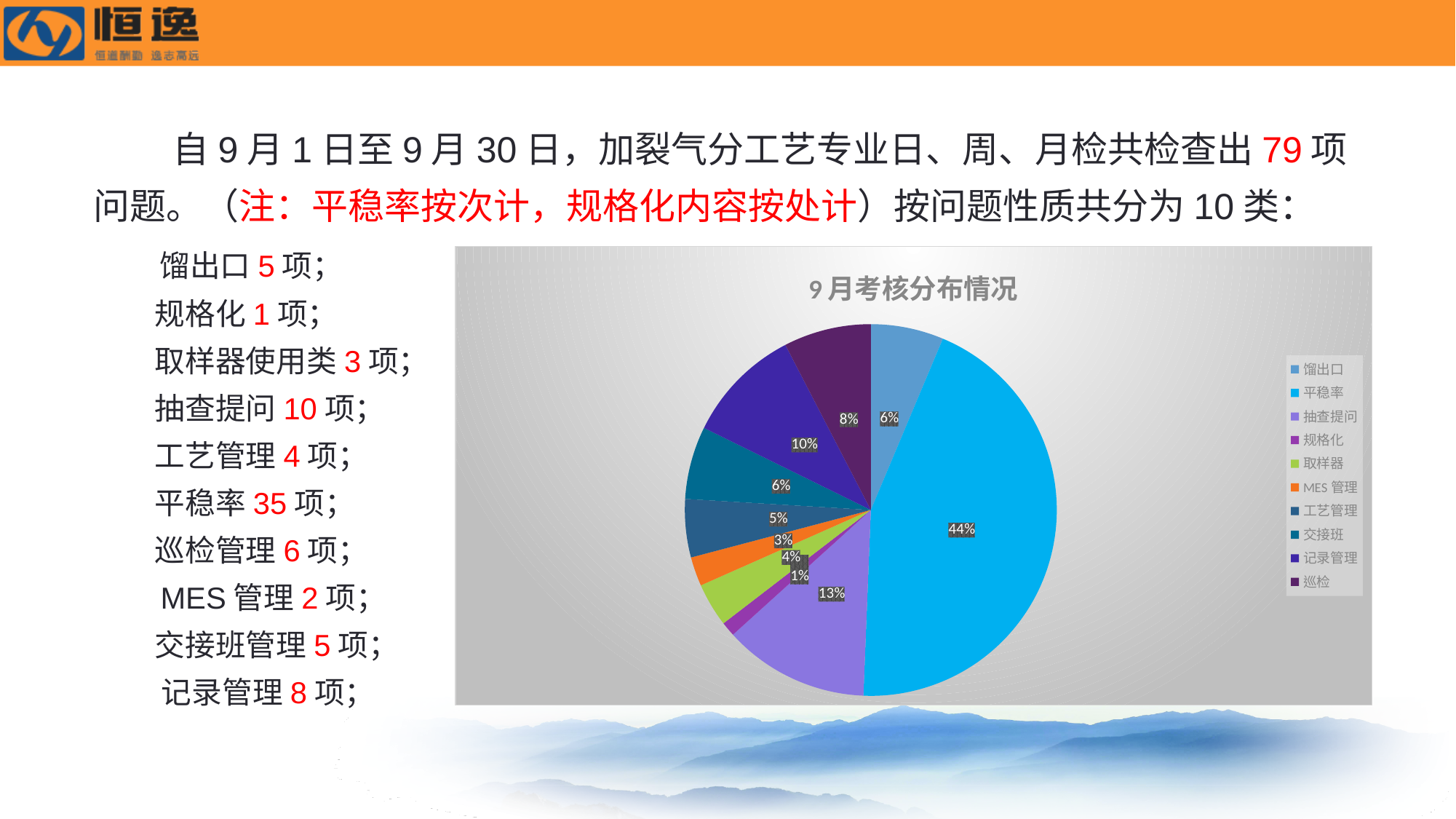
What is the difference in percentage points between 平稳率 and 抽查提问? 31 What is the percentage shown for MES 管理? 3% Which category has the largest slice of the pie? 平稳率 Which has a larger share, 记录管理 or 工艺管理? 记录管理 What is the percentage shown for 巡检? 8% Which category has the smallest slice of the pie? 规格化 What is the percentage shown for 记录管理? 10% What kind of chart is shown on the slide? pie chart What is the title of the chart? 9月考核分布情况 How many categories does the legend of the pie chart list? 10 What share of the pie does 平稳率 account for? 44% What is the percentage shown for 抽查提问? 13%